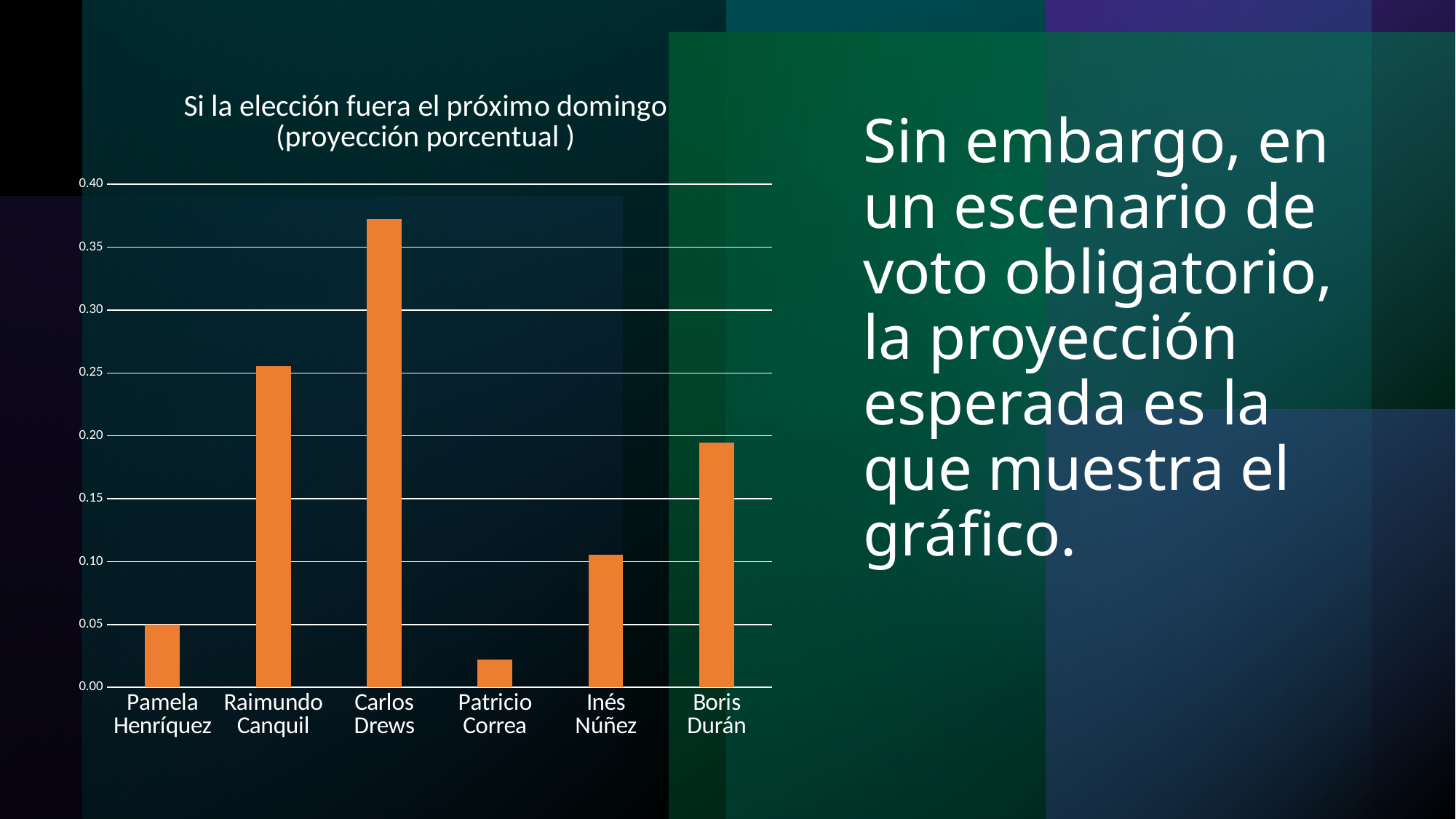
Is the value for Patricio Correa greater or less than 0.05? less How many candidates are shown on the x axis of the chart? 6 Which candidate has the highest projected value in the chart? Carlos Drews Which candidate has the lowest projected value in the chart? Patricio Correa Which is larger, the value for Pamela Henríquez or the value for Inés Núñez? Inés Núñez Which is larger, the value for Raimundo Canquil or the value for Boris Durán? Raimundo Canquil What kind of chart is shown on the slide? bar chart Is the value for Carlos Drews greater or less than 0.35? greater What is the title of the chart? Si la elección fuera el próximo domingo (proyección porcentual )